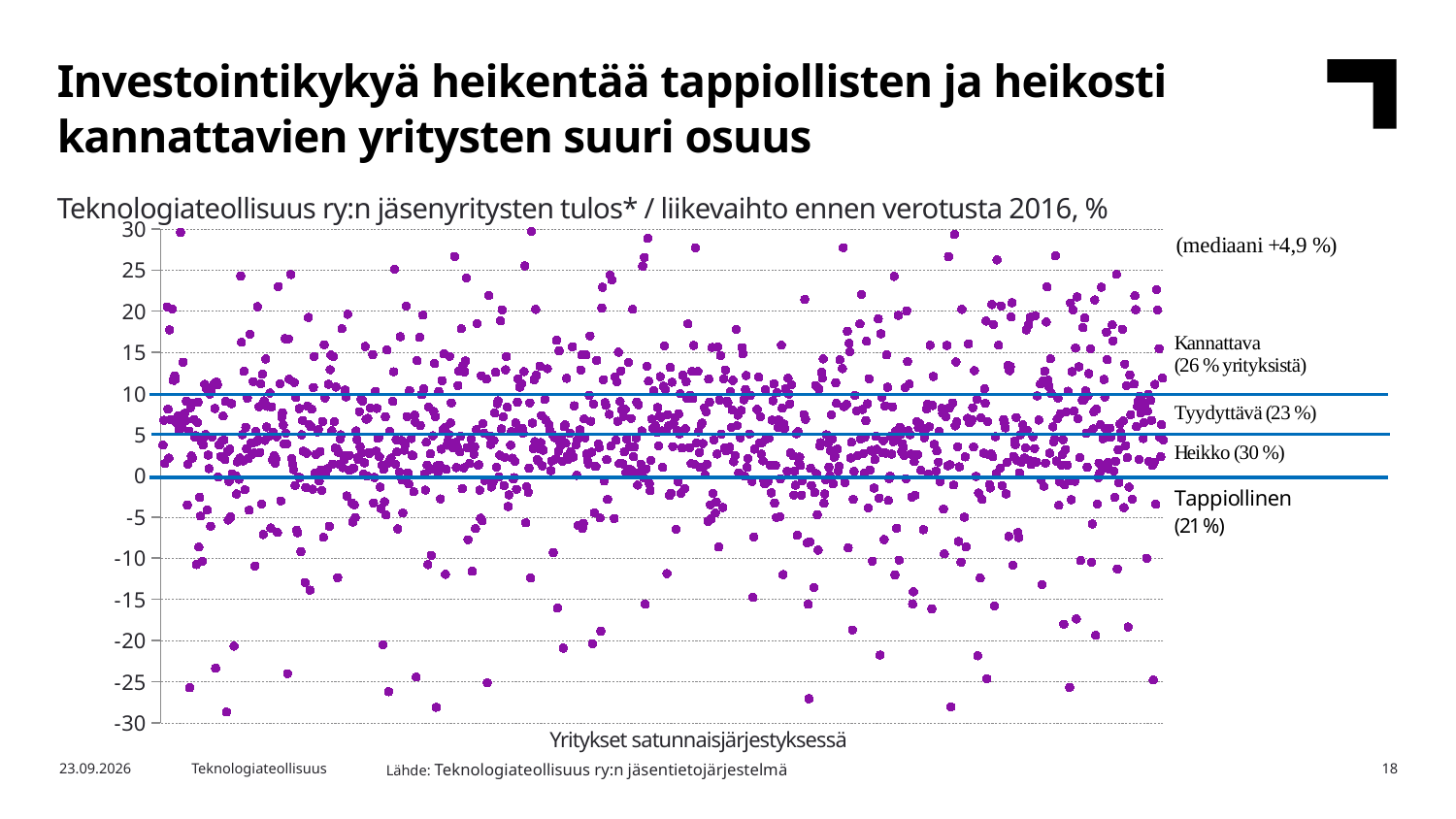
What share of companies is in the 'Heikko' group according to the chart annotation? 30 % Which of the four profitability groups has the smallest share of companies? Tappiollinen What kind of chart is shown on the slide? Scatter chart What is the title of the chart? Teknologiateollisuus ry:n jäsenyritysten tulos* / liikevaihto ennen verotusta 2016, % What is the label of the x axis of the chart? Yritykset satunnaisjärjestyksessä What share of companies is in the 'Kannattava' group according to the chart annotation? 26 % Which group has a larger share of companies, 'Kannattava' or 'Tyydyttävä'? Kannattava Which of the four profitability groups has the largest share of companies? Heikko How many percentage points larger is the share of 'Heikko' companies than the share of 'Tappiollinen' companies? 9 What share of companies is in the 'Tappiollinen' group according to the chart annotation? 21 % What is the median value of the profit / turnover ratio stated on the chart? +4,9 % What share of companies is in the 'Tyydyttävä' group according to the chart annotation? 23 %